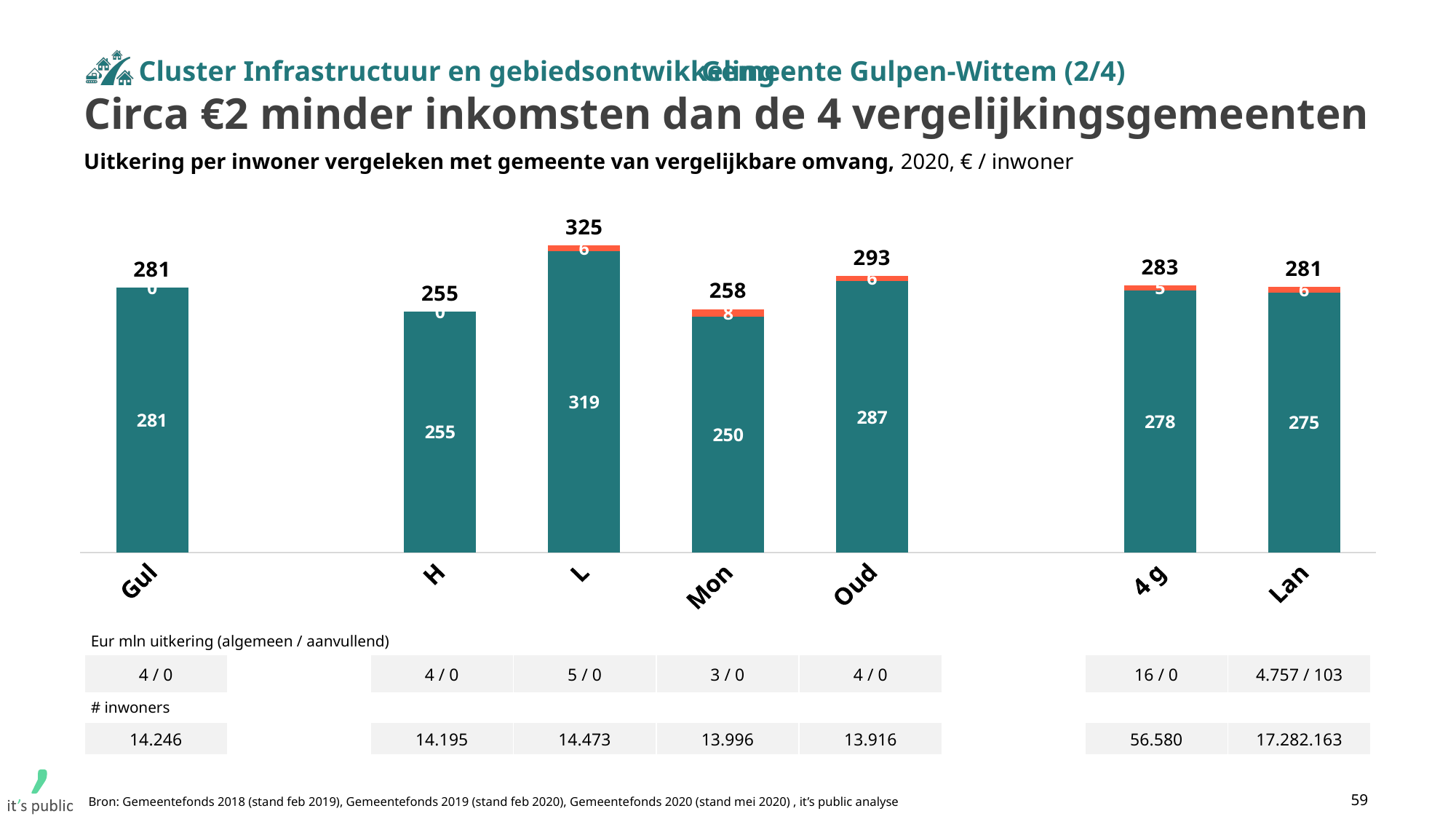
What is the value of the teal (lower) segment for Lan? 275 How many categories are shown on the x axis? 7 What is the total value shown above the bar for L? 325 What is the total of the stacked bar for 4 g? 283 What is the value of the teal (lower) segment for Oud? 287 Which category has the highest total value? L Which category has the lowest total value? H What is the value of the orange (upper) segment for Mon? 8 What kind of chart is shown on the slide? Stacked bar chart What is the difference between the total for Oud and the total for H? 38 Which has a larger total, Oud or Mon? Oud What is the difference between the total for L and the total for Gul? 44